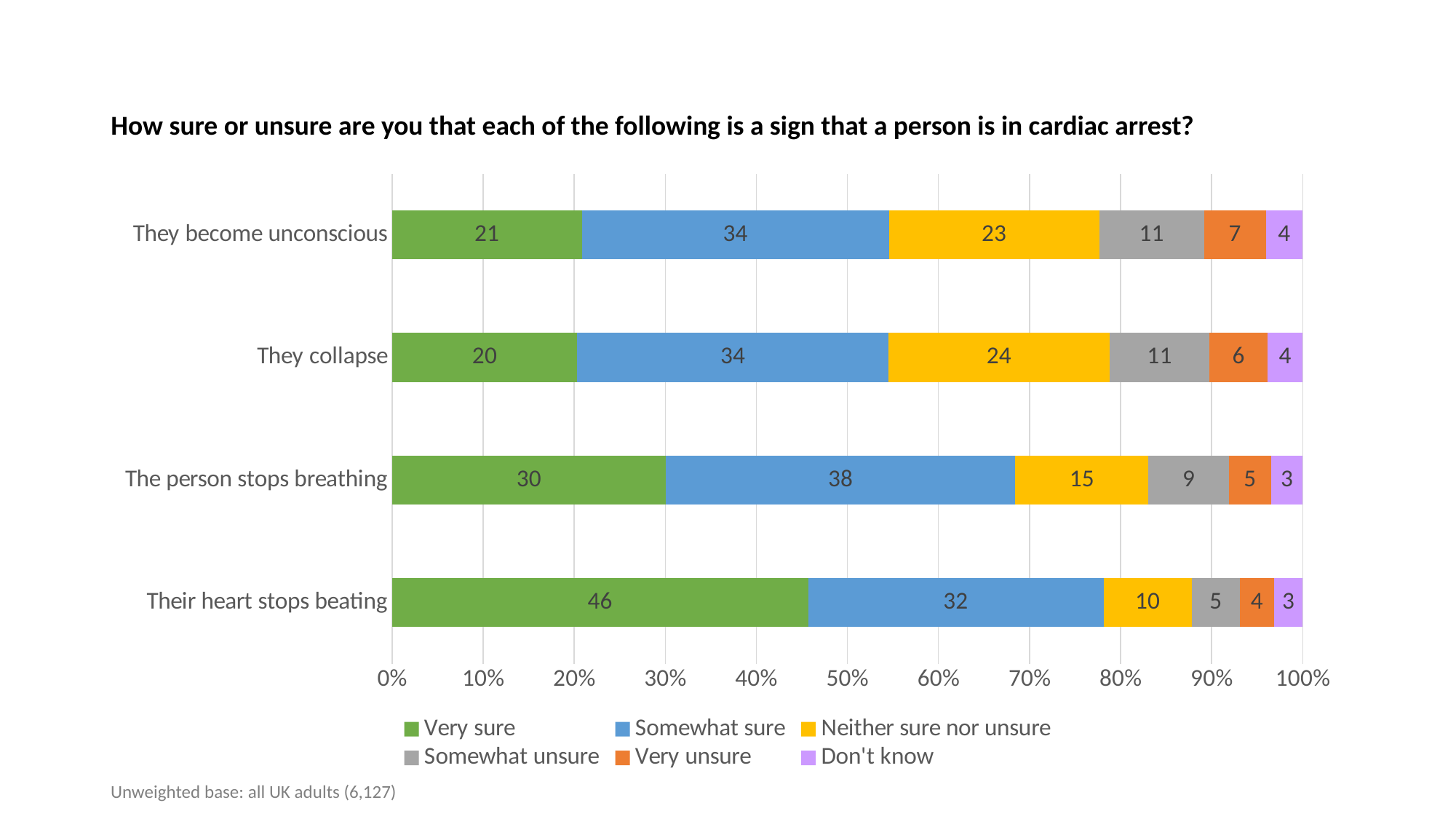
What is the 'Neither sure nor unsure' value for 'They collapse'? 24 What is the difference between the 'Very sure' values for 'Their heart stops beating' and 'The person stops breathing'? 16 Which category has the highest 'Very sure' value? Their heart stops beating Which is larger: the 'Somewhat unsure' value for 'They collapse' or for 'Their heart stops beating'? They collapse How many series does the legend list? 6 Which category has the lowest 'Neither sure nor unsure' value? Their heart stops beating What is the 'Very unsure' value for 'They become unconscious'? 7 What kind of chart is shown on the slide? Stacked bar chart Which colour represents 'Don't know' in the legend? Purple How many categories are shown on the chart? 4 What is the 'Somewhat sure' value for 'The person stops breathing'? 38 What is the 'Very sure' value for 'Their heart stops beating'? 46